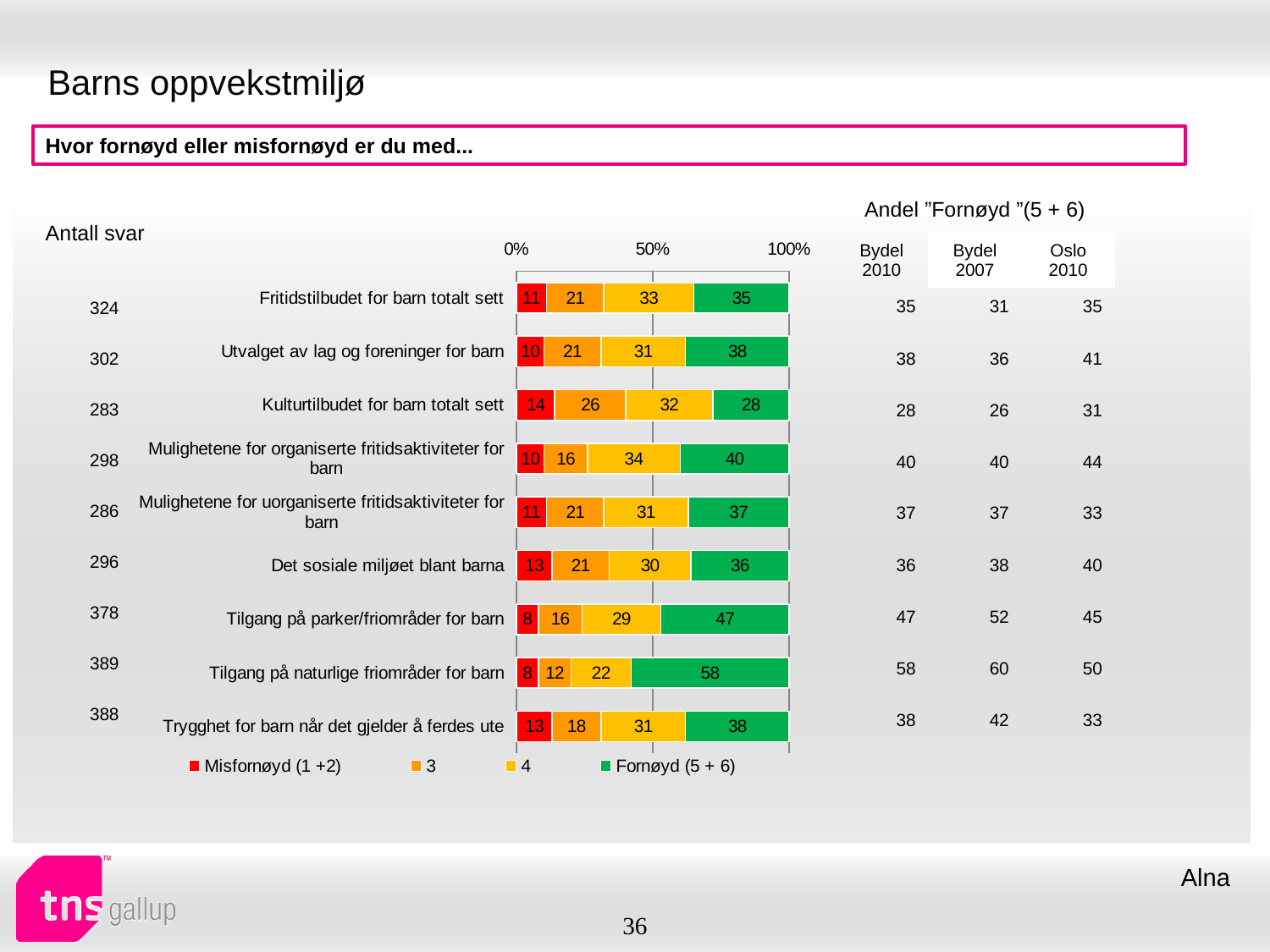
How many series does the chart legend list? 4 What is the Misfornøyd (1 +2) value for 'Kulturtilbudet for barn totalt sett'? 14 What is the value of series '4' for 'Mulighetene for organiserte fritidsaktiviteter for barn'? 34 What kind of chart is shown on the slide? Stacked bar chart Which category has the highest Fornøyd (5 + 6) value? Tilgang på naturlige friområder for barn How many categories (statements) are plotted in the chart? 9 What is the label of the first (red) series in the legend? Misfornøyd (1 +2) What is the total of the stacked bar for 'Fritidstilbudet for barn totalt sett'? 100 What is the Fornøyd (5 + 6) value for 'Tilgang på naturlige friområder for barn'? 58 What is the difference between the Fornøyd (5 + 6) values for 'Tilgang på parker/friområder for barn' and 'Det sosiale miljøet blant barna'? 11 Which has a larger Misfornøyd (1 +2) value: 'Det sosiale miljøet blant barna' or 'Tilgang på parker/friområder for barn'? Det sosiale miljøet blant barna Which category has the lowest Fornøyd (5 + 6) value? Kulturtilbudet for barn totalt sett